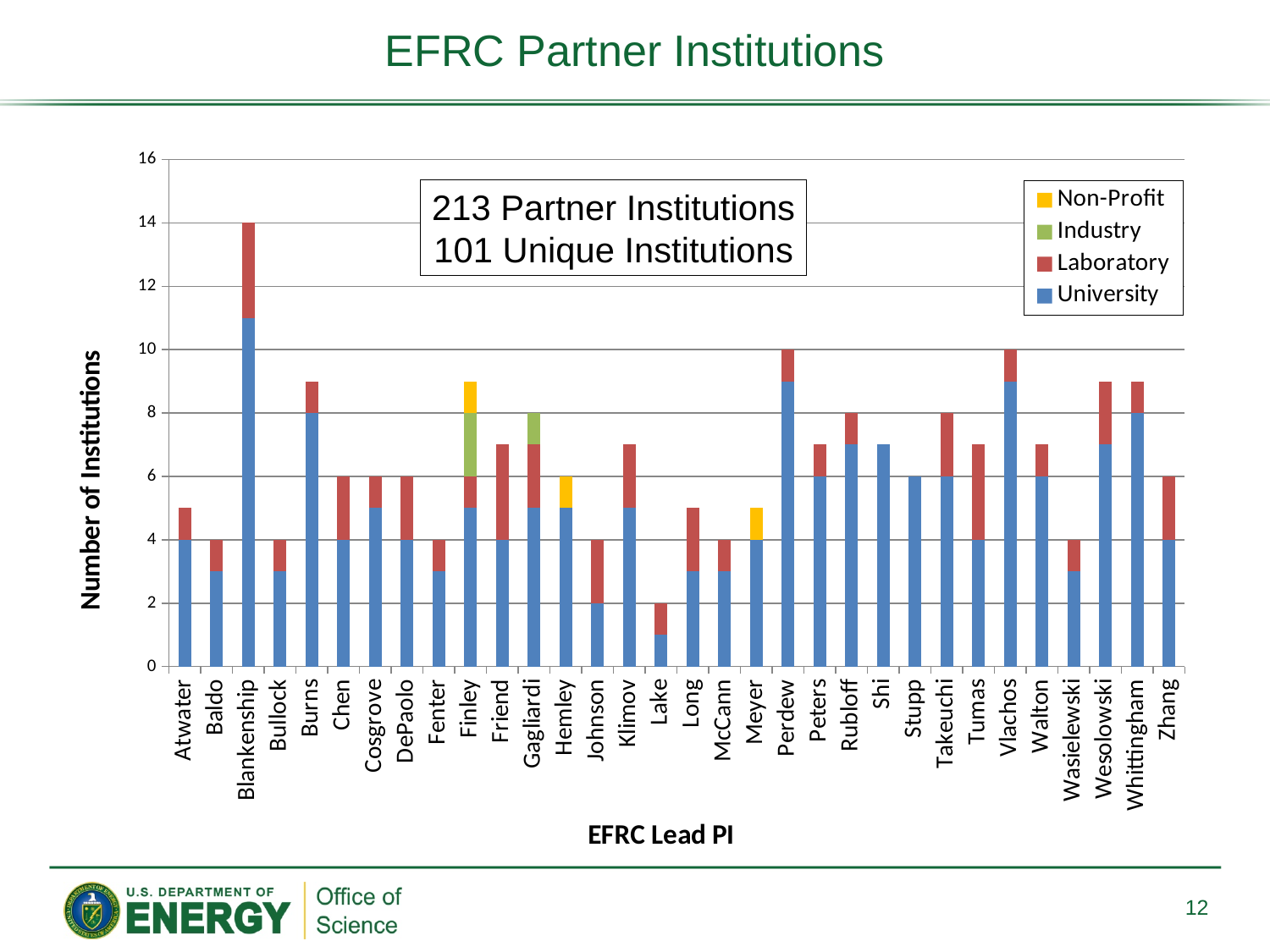
Is the total value for Atwater greater or less than 4? greater How many series does the legend list? 4 Which EFRC Lead PI has the lowest total number of institutions? Lake What is the total number of institutions for Lake? 2 Which has a larger total number of institutions, Blankenship or Perdew? Blankenship Which EFRC Lead PI has the highest total number of institutions? Blankenship What is the total number of institutions for Perdew? 10 What is the total number of institutions for Blankenship? 14 What is the title of the x axis? EFRC Lead PI What type of chart is shown on the slide? Stacked bar chart Is the total value for Burns greater or less than 8? greater How many EFRC Lead PIs are shown on the x axis? 32